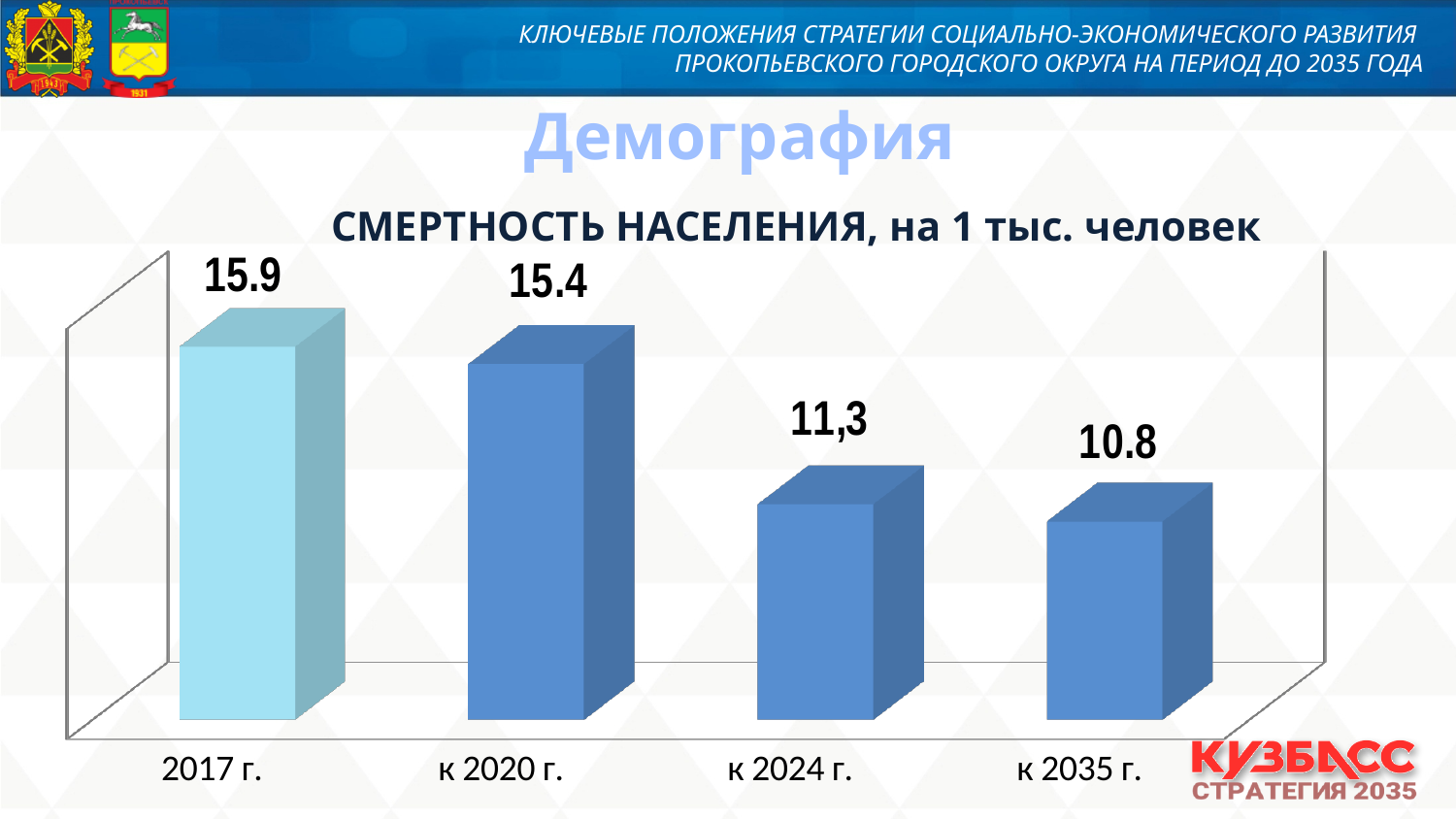
What is the difference between the values for 2017 г. and к 2020 г.? 0.5 What value is shown for к 2035 г.? 10.8 What is the difference between the values for 2017 г. and к 2035 г.? 5.1 Which category has the lowest value on the chart? к 2035 г. What kind of chart is shown on the slide? Bar chart What value is shown for к 2020 г.? 15.4 What value is shown for к 2024 г.? 11,3 Which is larger, the value for 2017 г. or the value for к 2020 г.? 2017 г. What is the mortality rate value shown for 2017 г.? 15.9 Which category has the highest value on the chart? 2017 г. How many categories are shown on the chart? 4 Do the values rise or fall from 2017 г. to к 2035 г.? Fall